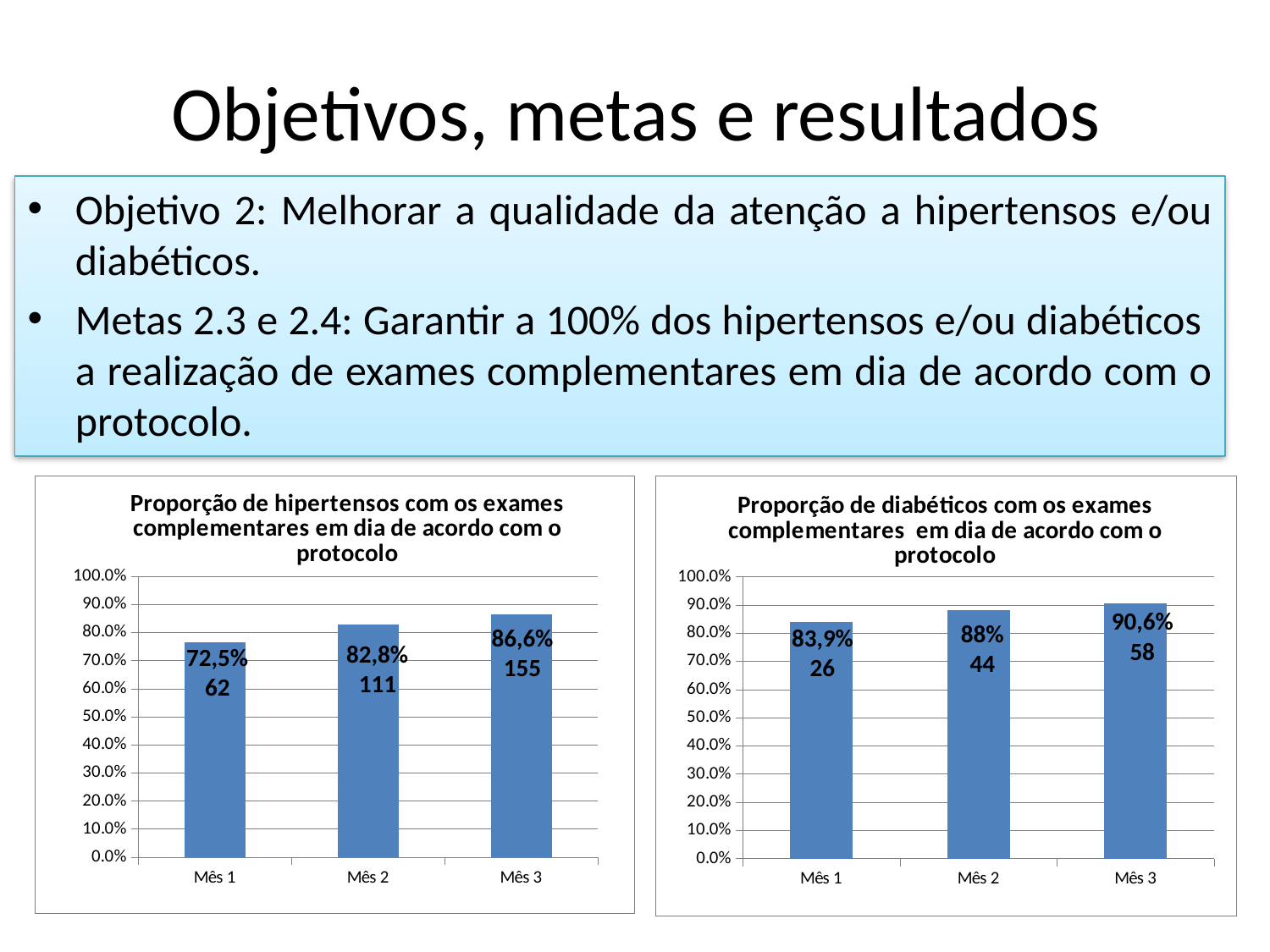
In the left chart (Proporção de hipertensos), which month has the highest percentage? Mês 3 How many bars does the right chart (Proporção de diabéticos) show? 3 In the right chart (Proporção de diabéticos), which is larger, the percentage for Mês 2 or for Mês 3? Mês 3 In the right chart (Proporção de diabéticos), do the values rise or fall from Mês 1 to Mês 3? rise In the left chart (Proporção de hipertensos com os exames complementares em dia de acordo com o protocolo), what is the percentage for Mês 1? 72,5% In the left chart (Proporção de hipertensos), is the value for Mês 2 greater or less than 80.0%? greater In the right chart (Proporção de diabéticos com os exames complementares em dia de acordo com o protocolo), what count is shown on the bar for Mês 1? 26 In the right chart (Proporção de diabéticos), which month has the lowest percentage? Mês 1 In the left chart (Proporção de hipertensos), what is the difference in percentage points between Mês 3 and Mês 1? 14,1 What kind of chart is the left chart (Proporção de hipertensos)? bar chart In the left chart (Proporção de hipertensos com os exames complementares em dia de acordo com o protocolo), what count is shown on the bar for Mês 3? 155 In the right chart (Proporção de diabéticos com os exames complementares em dia de acordo com o protocolo), what is the percentage for Mês 2? 88%